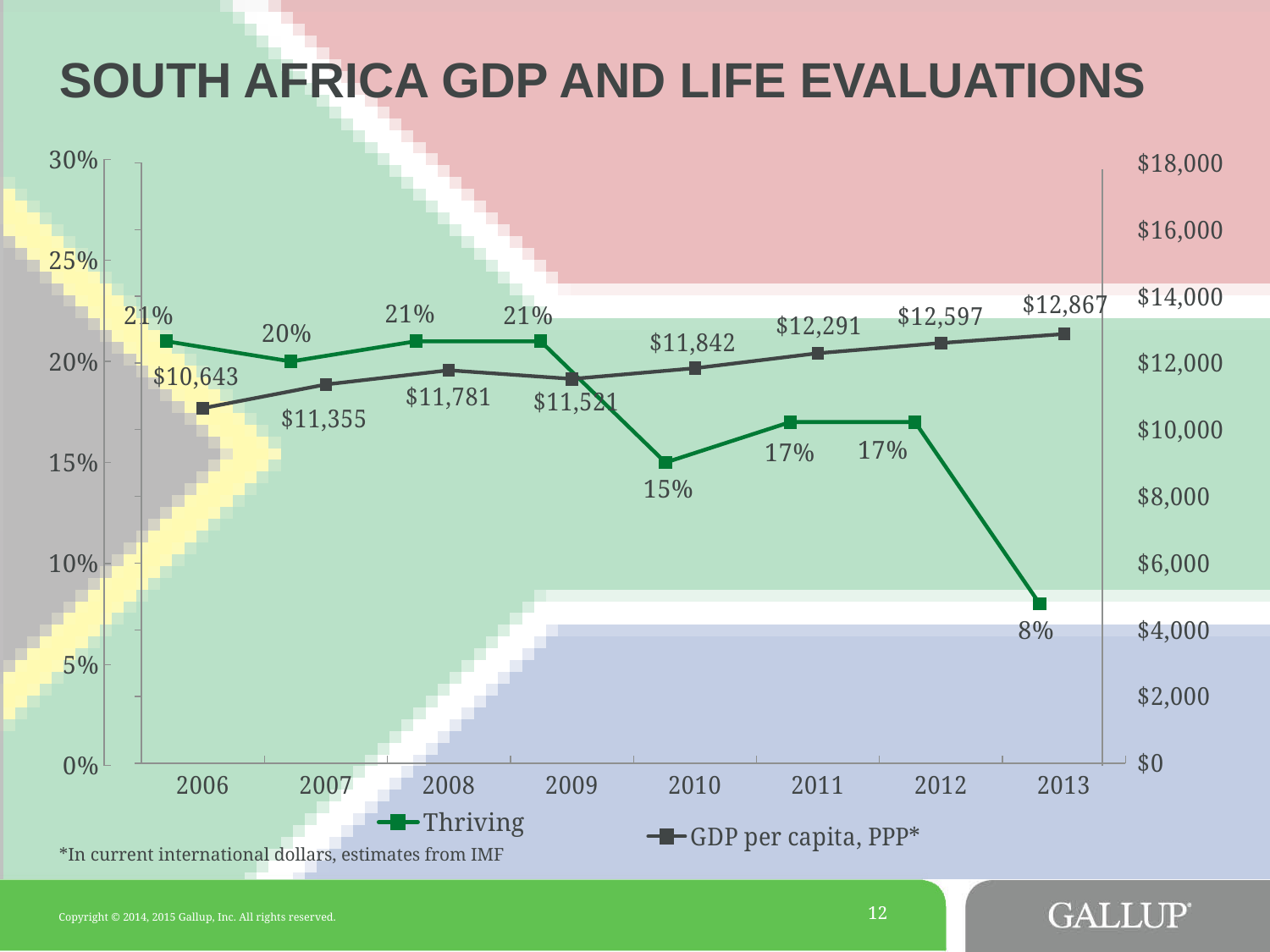
What is the Thriving value for 2013? 8% How many series does the legend list? 2 What kind of chart is shown on the slide? Line chart Which year has a higher GDP per capita, PPP: 2008 or 2009? 2008 What is the Thriving value for 2010? 15% What is the difference between the Thriving values for 2009 and 2010? 6% What is the difference in GDP per capita, PPP between 2013 and 2012? $270 How many years are plotted on the x axis? 8 In which year is the Thriving value lowest? 2013 What is the GDP per capita, PPP value for 2011? $12,291 What is the GDP per capita, PPP value for 2006? $10,643 In which year is GDP per capita, PPP highest? 2013